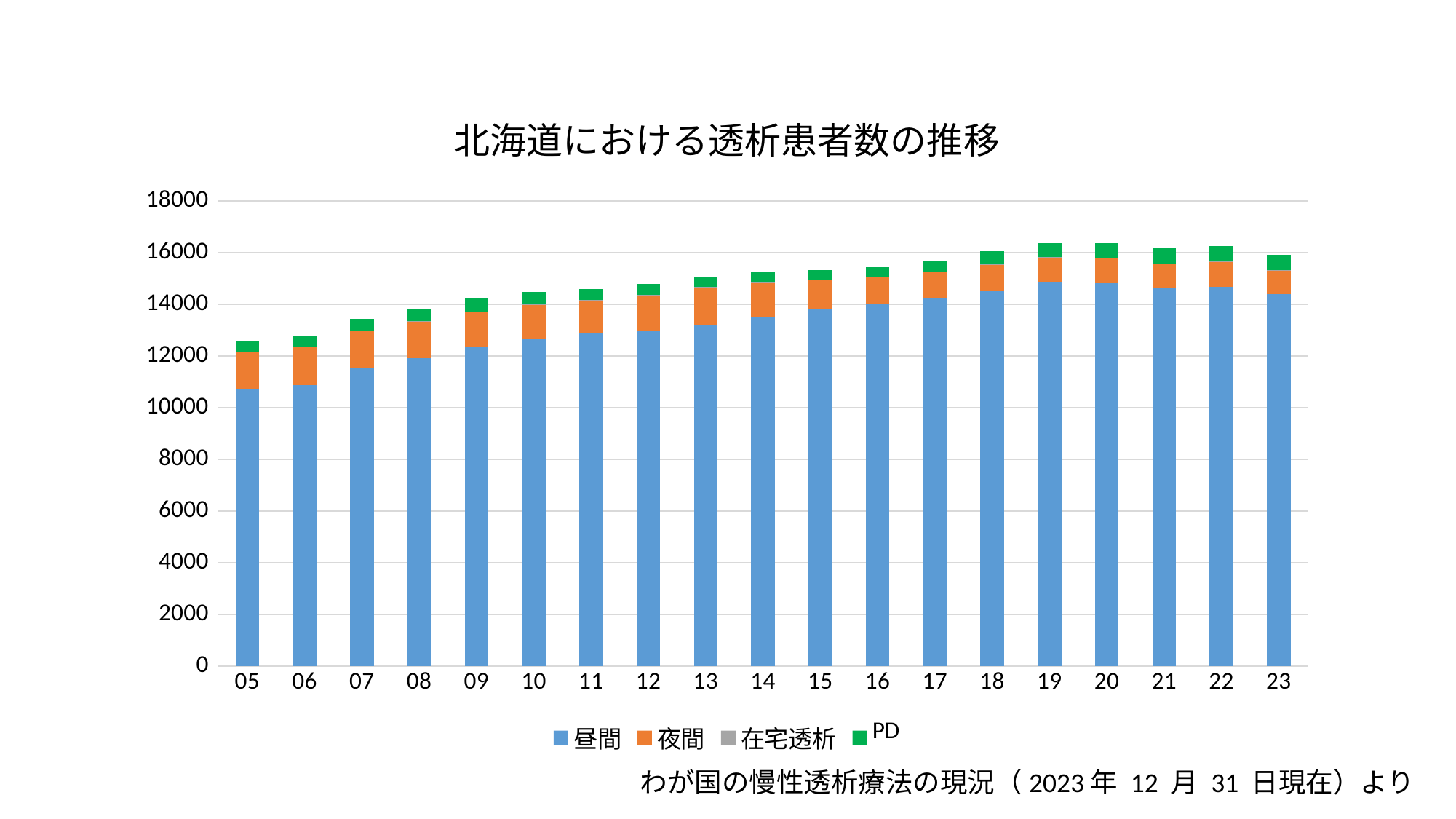
How many years (categories) are shown on the x axis? 19 Which is larger, the total stacked bar for 05 or for 23? 23 What is the title of the chart? 北海道における透析患者数の推移 Do the total stacked bars generally rise or fall from 05 to 19? rise Is the value for 昼間 in 05 greater or less than 10000? greater How many series does the legend list? 4 Is the total stacked bar for 05 greater or less than 14000? less What kind of chart is shown on the slide? stacked bar chart Which series is shown in green in the legend? PD Is the value for 昼間 in 20 greater or less than 16000? less Which year has the lowest total stacked bar? 05